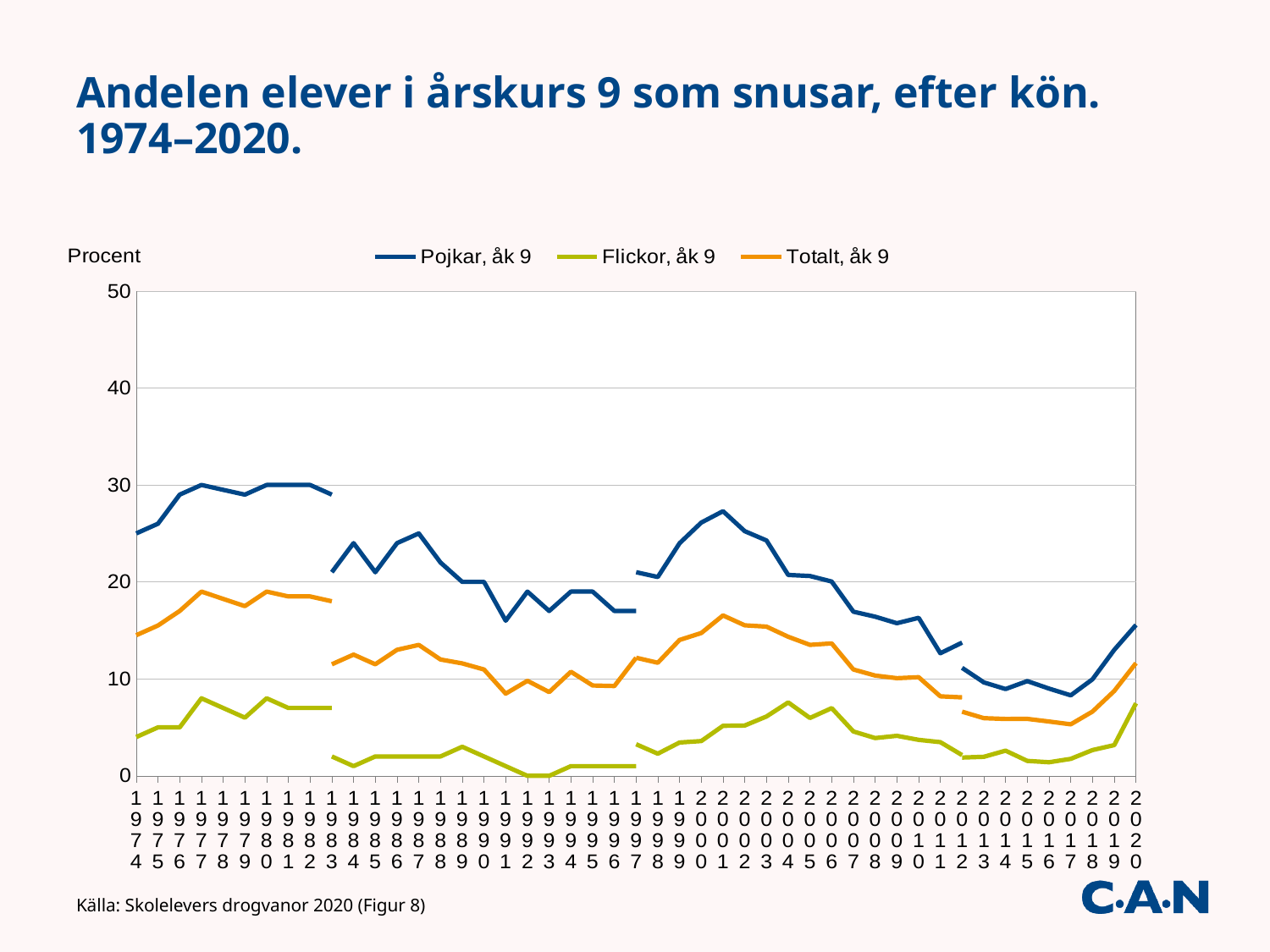
Is the value for Pojkar, åk 9 in 1974 greater or less than 20? greater Which series has the higher value in 1974, Pojkar, åk 9 or Flickor, åk 9? Pojkar, åk 9 What are the three series named in the legend? Pojkar, åk 9; Flickor, åk 9; Totalt, åk 9 Is the value for Flickor, åk 9 in 2012 greater or less than 10? less What kind of chart is shown on the slide? line chart What is the label shown on the vertical axis of the chart? Procent Is the value for Flickor, åk 9 in 1974 greater or less than 10? less Does the Pojkar, åk 9 line rise or fall between 2001 and 2017? fall Which series has the lowest values across the whole period? Flickor, åk 9 How many series does the legend list? 3